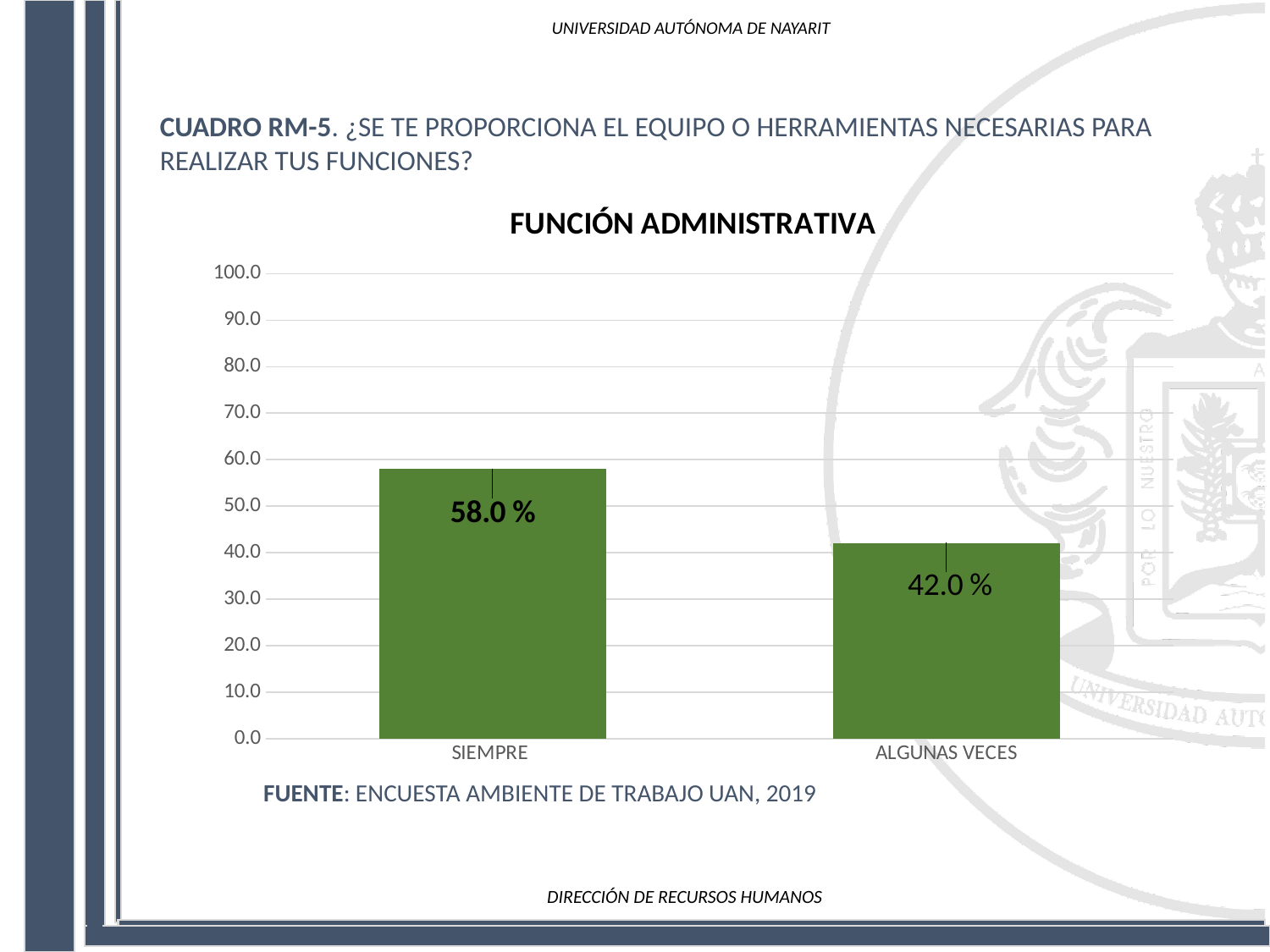
Which category has the lowest value? ALGUNAS VECES Which is larger, the value for SIEMPRE or the value for ALGUNAS VECES? SIEMPRE Which category has the highest value? SIEMPRE What is the difference between the values for SIEMPRE and ALGUNAS VECES? 16.0 % What is the value for ALGUNAS VECES? 42.0 % What is the title of the chart? FUNCIÓN ADMINISTRATIVA What is the value for SIEMPRE? 58.0 % How many categories are shown on the x axis? 2 Is the value for SIEMPRE greater or less than 50.0? greater Is the value for ALGUNAS VECES greater or less than 50.0? less What kind of chart is shown? bar chart What is the highest value shown on the y axis? 100.0